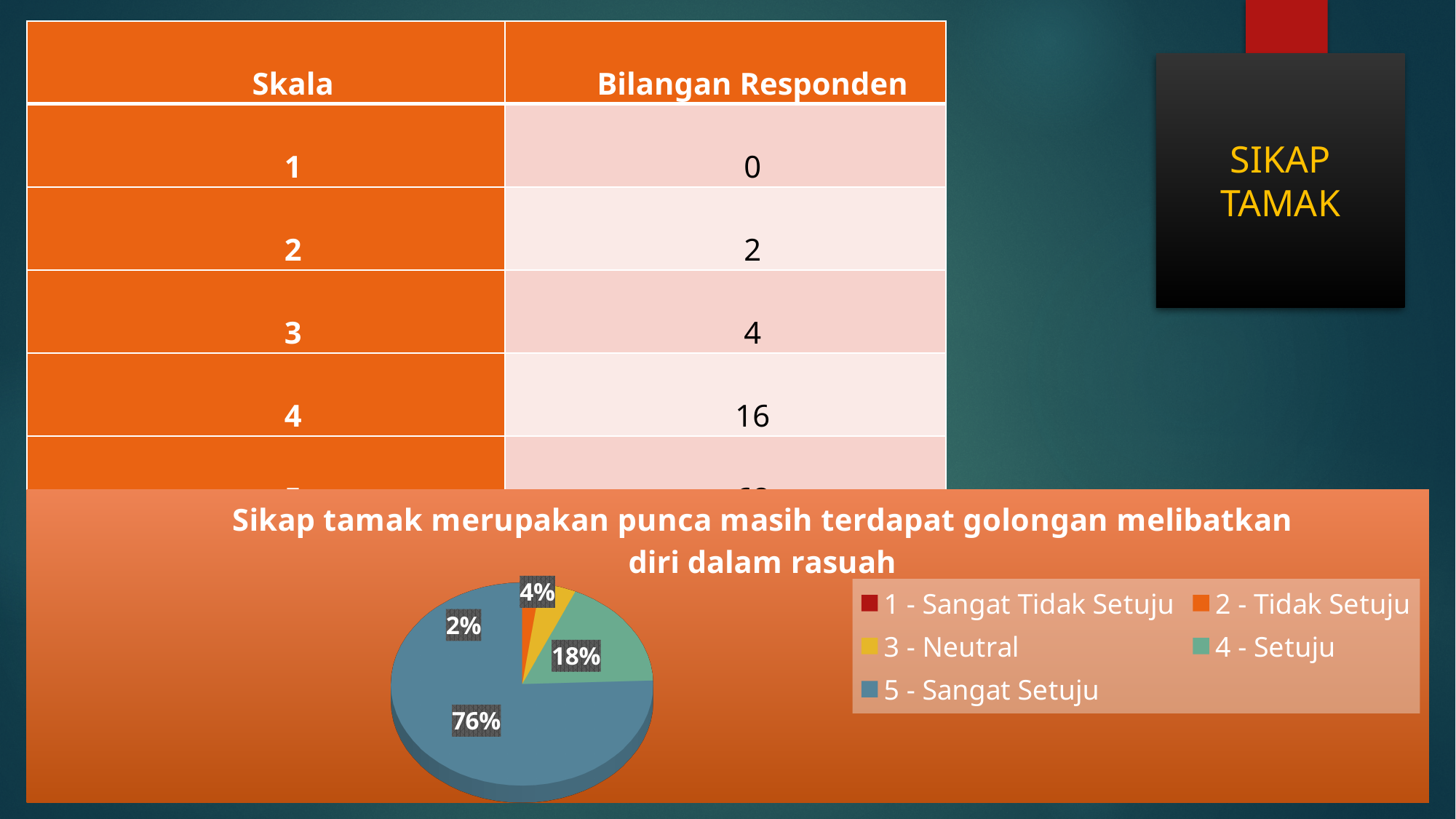
What share of the pie does "3 - Neutral" have? 4% What share of the pie does "4 - Setuju" have? 18% What share of the pie does "2 - Tidak Setuju" have? 2% What colour is the slice for "5 - Sangat Setuju" in the pie chart? blue What is the title of the pie chart? Sikap tamak merupakan punca masih terdapat golongan melibatkan diri dalam rasuah What is the difference in percentage points between the "5 - Sangat Setuju" slice and the "4 - Setuju" slice? 58 What kind of chart is shown on the slide? pie chart Which category has the largest slice of the pie? 5 - Sangat Setuju How many entries does the legend of the pie chart list? 5 Which is larger, the slice for "4 - Setuju" or the slice for "3 - Neutral"? 4 - Setuju What share of the pie does "5 - Sangat Setuju" have? 76%